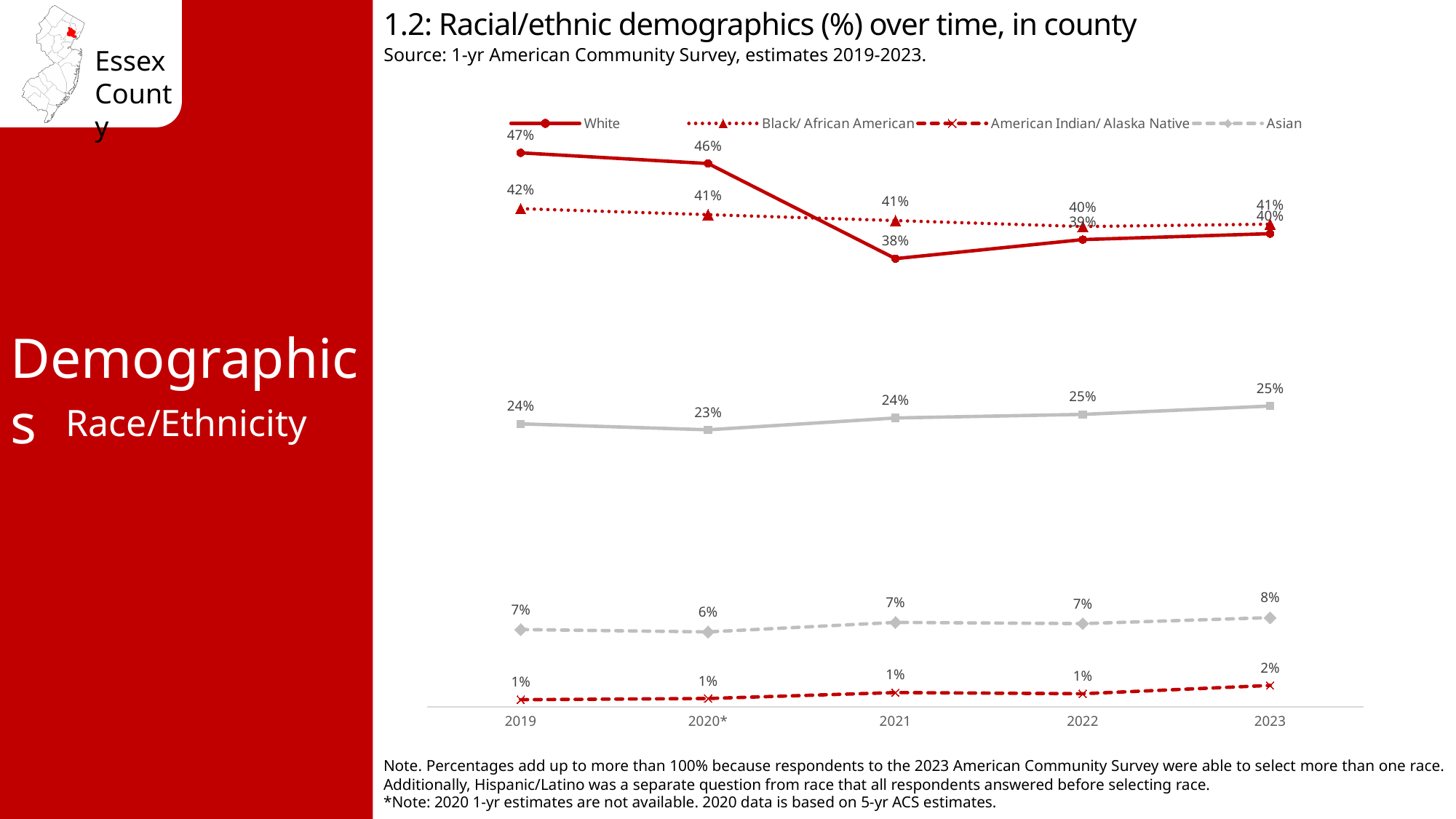
How many years are shown on the x axis? 5 In which year was the Asian percentage highest? 2023 What was the Black/ African American percentage in 2021? 41% What kind of chart is this? Line chart What was the American Indian/ Alaska Native percentage in 2023? 2% What was the White percentage in 2022? 39% In which year was the White percentage lowest? 2021 What was the Asian percentage in 2023? 8% What was the White percentage in 2019? 47% Did the White percentage rise or fall from 2019 to 2021? Fall By how many percentage points did the White share fall from 2019 to 2021? 9 percentage points In 2021, which was larger: the White share or the Black/ African American share? Black/ African American